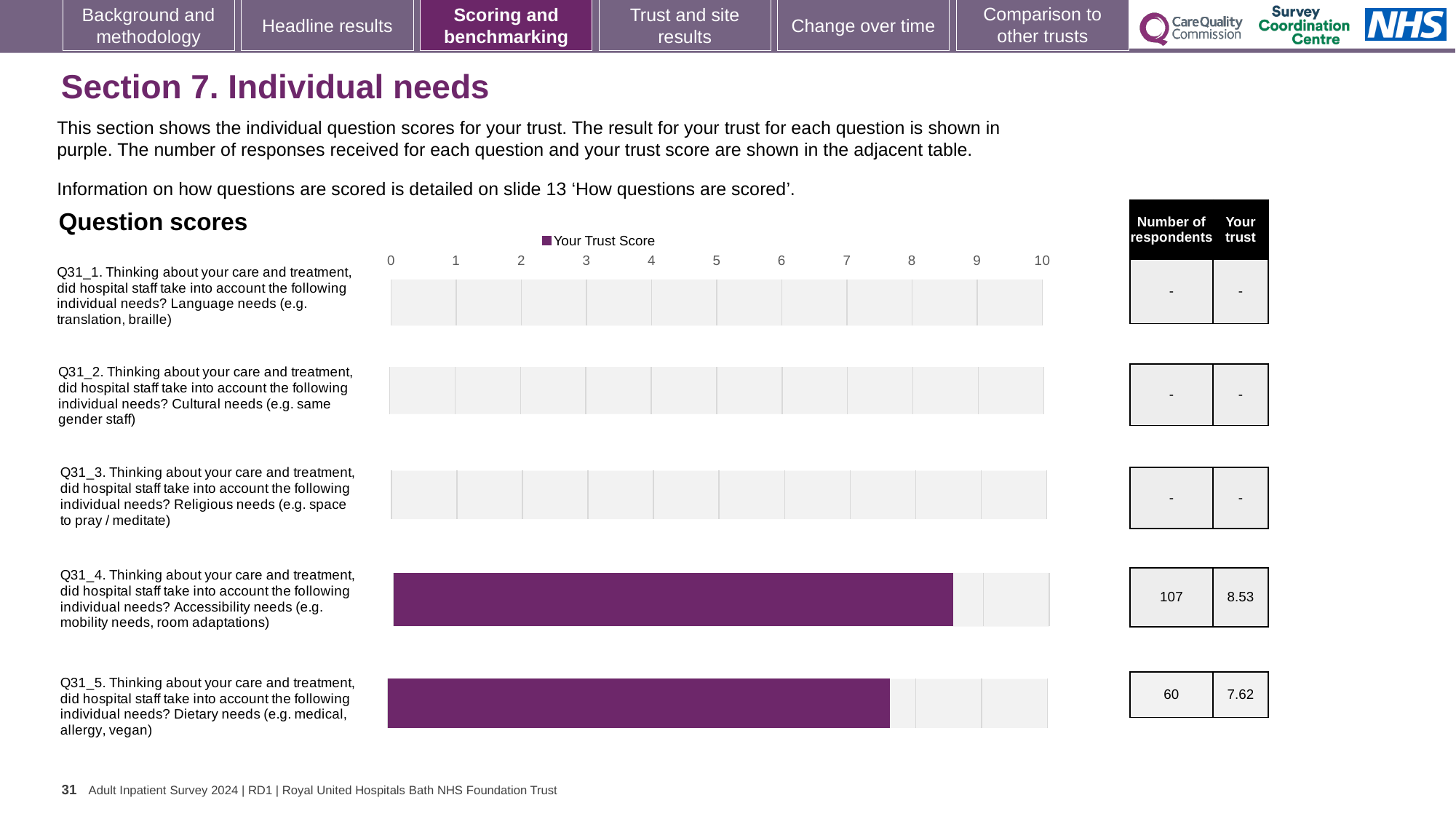
Is the value for Q31_5 (Dietary needs) greater or less than 8? less How many questions are listed on the chart? 5 What is the difference between the trust scores for Q31_4 and Q31_5? 0.91 Which has the larger trust score, Q31_4 (Accessibility needs) or Q31_5 (Dietary needs)? Q31_4 (Accessibility needs) How many respondents answered Q31_4 (Accessibility needs)? 107 Which question has the highest trust score shown on the chart? Q31_4 (Accessibility needs) Which of the questions with a plotted bar has the lowest trust score? Q31_5 (Dietary needs) What kind of chart is shown on the slide? Bar chart How many respondents answered Q31_5 (Dietary needs)? 60 What is the trust score for Q31_4 (Accessibility needs)? 8.53 How many series does the legend list? 1 What is the trust score for Q31_5 (Dietary needs)? 7.62